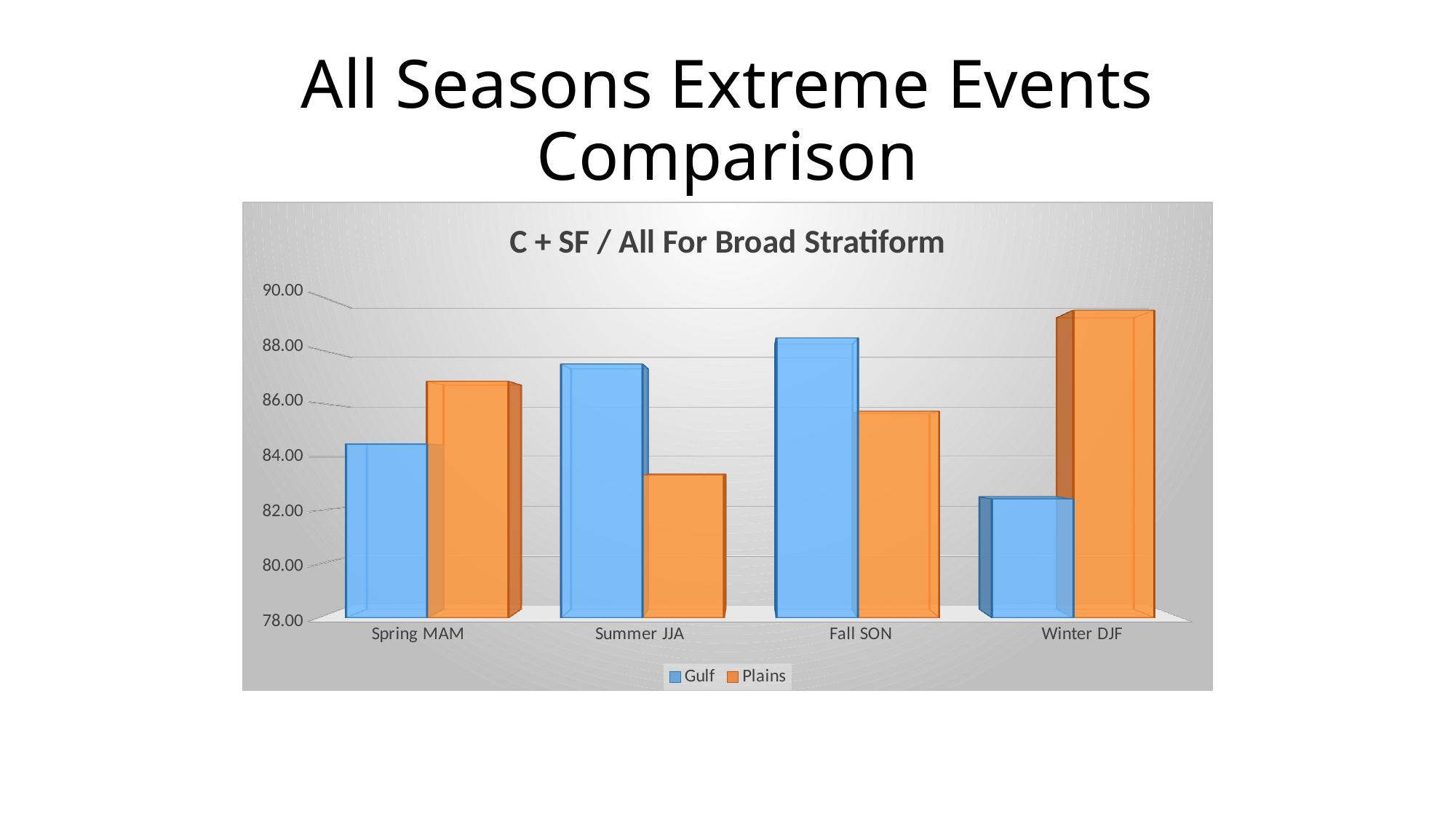
For Spring MAM, which is larger, Gulf or Plains? Plains Is the Gulf value for Winter DJF greater or less than 84.00? less Is the Plains value for Winter DJF greater or less than 88.00? greater Which season has the lowest Gulf value? Winter DJF How many season categories are shown on the x axis? 4 Which season has the lowest Plains value? Summer JJA Which season has the highest Gulf value? Fall SON What kind of chart is shown on the slide? bar chart Which season has the highest Plains value? Winter DJF What is the title of the chart? C + SF / All For Broad Stratiform How many series does the legend list? 2 For Summer JJA, which is larger, Gulf or Plains? Gulf